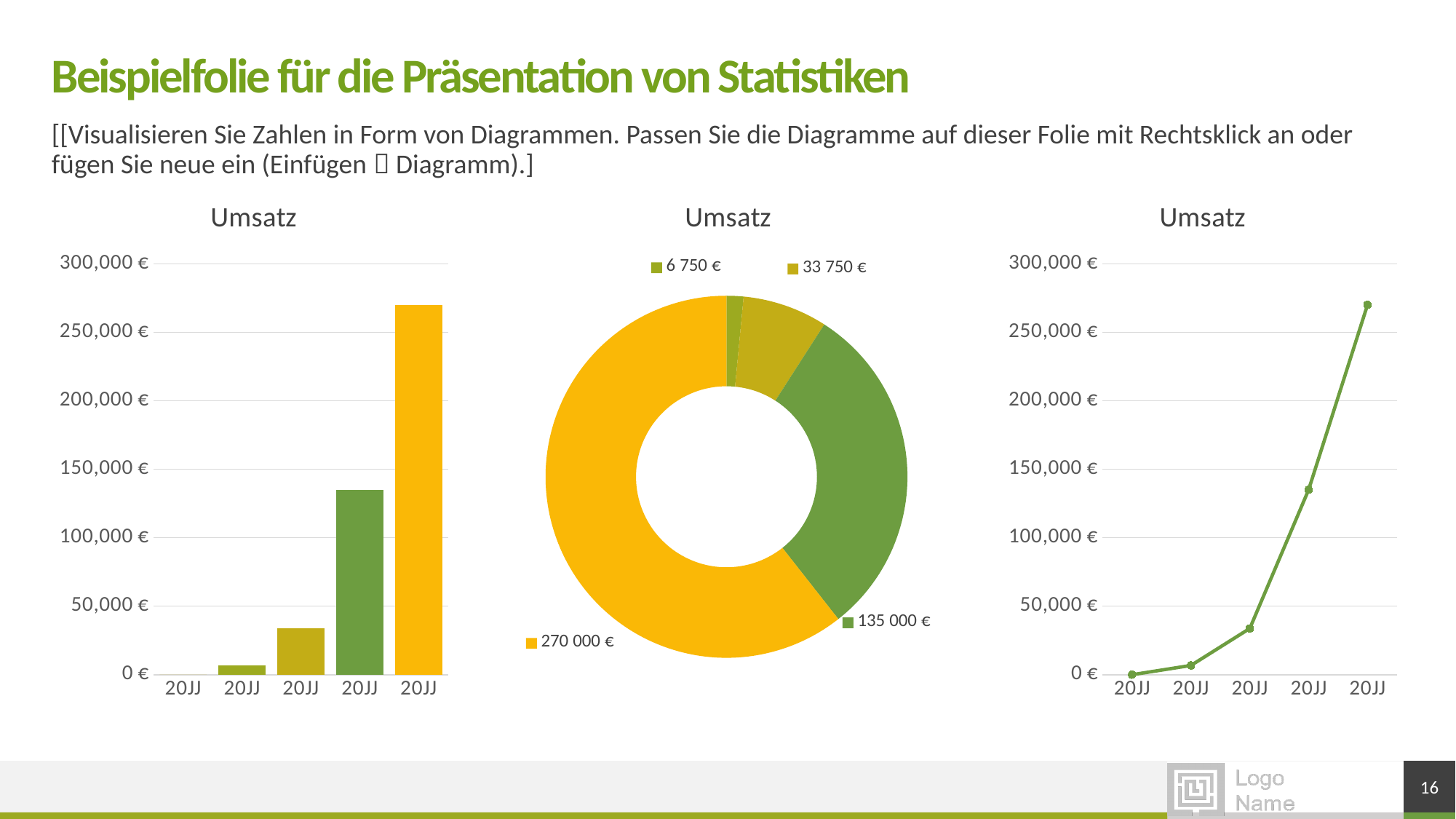
In the doughnut chart in the middle, what is the total of all four values shown? 445 500 € What kind of chart is the chart in the middle of the slide? doughnut chart What kind of chart is the chart on the left of the slide? bar chart In the doughnut chart in the middle, what is the difference between the largest value (270 000 €) and the second largest value (135 000 €)? 135 000 € In the doughnut chart in the middle, what is the smallest value shown? 6 750 € What kind of chart is the chart on the right of the slide? line chart In the bar chart on the left, is the value of the fourth bar from the left greater or less than 100,000 €? greater In the doughnut chart in the middle, what is the largest value shown? 270 000 € In the bar chart on the left, is the value of the rightmost bar greater or less than 250,000 €? greater In the line chart on the right, do the values rise or fall from left to right along the x axis? rise In the bar chart on the left, how many bars are plotted? 4 In the bar chart on the left, is the value of the third bar from the left greater or less than 50,000 €? less